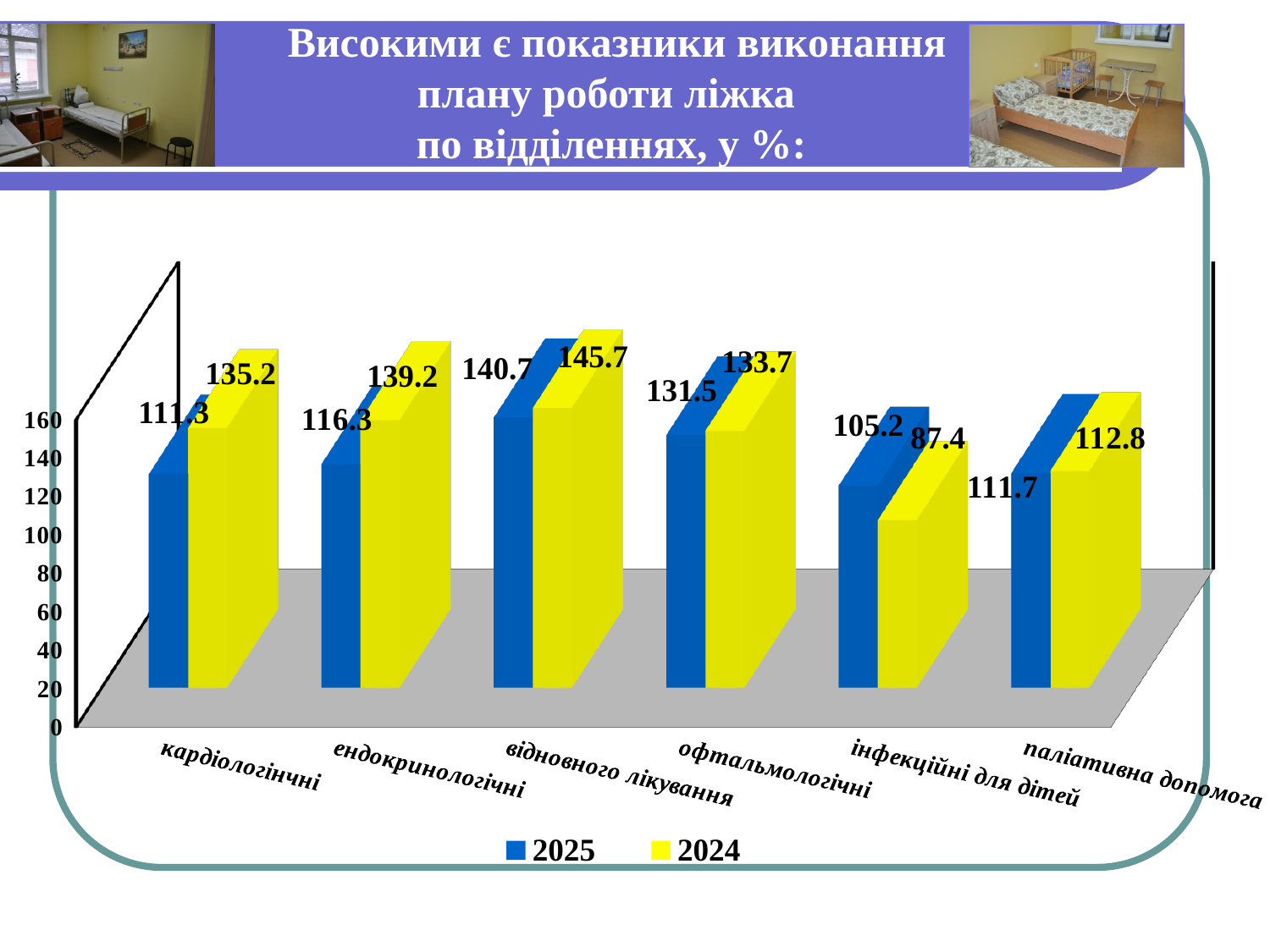
For інфекційні для дітей, which year has the larger value, 2025 or 2024? 2025 Which department has the lowest 2025 value? інфекційні для дітей How many series does the legend list? 2 What is the 2025 value for інфекційні для дітей? 105.2 What is the 2024 value for ендокринологічні? 139.2 What is the 2024 value for паліативна допомога? 112.8 Which series is shown in yellow according to the legend? 2024 What is the difference between the 2024 and 2025 values for ендокринологічні? 22.9 What kind of chart is shown on the slide? bar chart Which department has the highest 2024 value? відновного лікування What is the difference between the 2024 and 2025 values for відновного лікування? 5 How many departments are shown on the x axis? 6